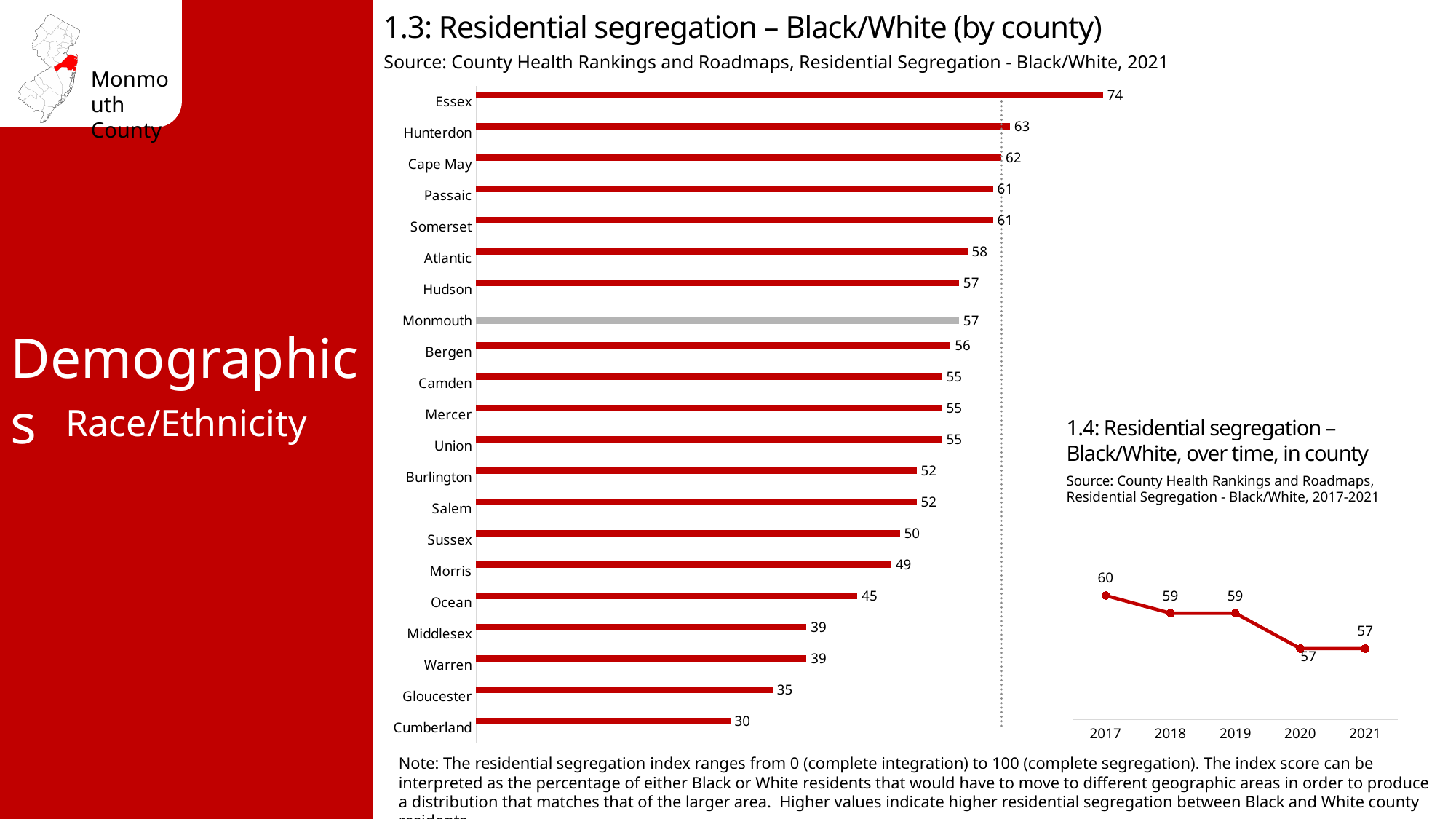
What kind of chart is '1.4: Residential segregation – Black/White, over time, in county'? Line chart In the chart '1.3: Residential segregation – Black/White (by county)', what is the difference between the values for Essex and Cumberland? 44 In the chart '1.3: Residential segregation – Black/White (by county)', which has a larger value, Atlantic or Ocean? Atlantic In the chart '1.3: Residential segregation – Black/White (by county)', which county has the highest value? Essex In the chart '1.3: Residential segregation – Black/White (by county)', which county's bar is shown in grey rather than red? Monmouth What kind of chart is '1.3: Residential segregation – Black/White (by county)'? Bar chart In the chart '1.3: Residential segregation – Black/White (by county)', what is the value for Gloucester? 35 In the chart '1.3: Residential segregation – Black/White (by county)', what is the value for Monmouth? 57 In the chart '1.4: Residential segregation – Black/White, over time, in county', what is the value for 2017? 60 In the chart '1.3: Residential segregation – Black/White (by county)', which county has the lowest value? Cumberland In the chart '1.4: Residential segregation – Black/White, over time, in county', do the values rise or fall from 2017 to 2020? Fall In the chart '1.3: Residential segregation – Black/White (by county)', how many counties are shown? 21